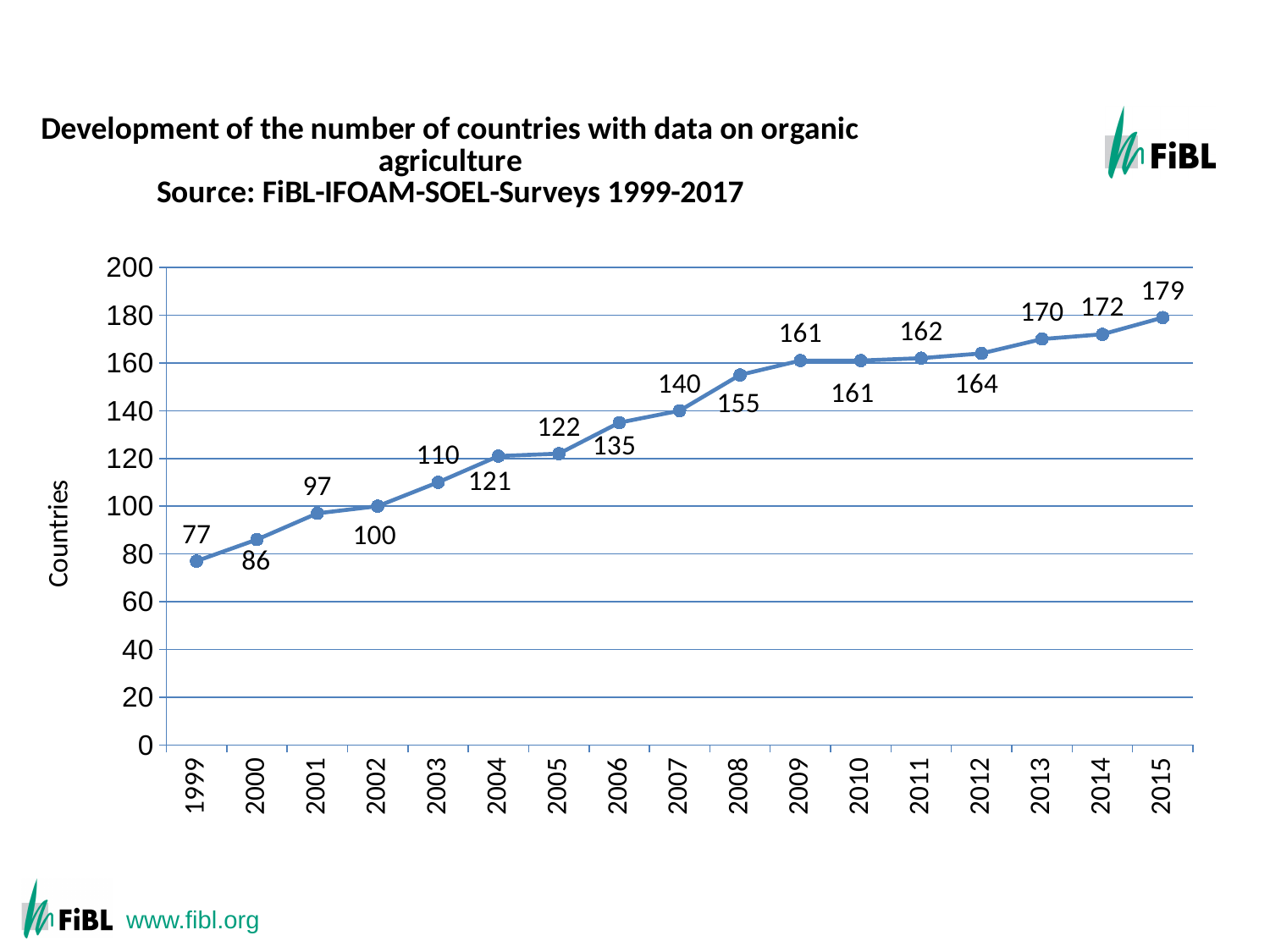
What is the difference between the number of countries in 2008 and in 2007? 15 Is the number of countries in 2002 greater or less than 120? less What kind of chart is shown on the slide? Line chart What is the difference between the number of countries in 2015 and in 1999? 102 Which year has the highest number of countries with data on organic agriculture? 2015 Do the values rise or fall from 1999 to 2015? Rise How many years are plotted on the chart? 17 What is the number of countries with data on organic agriculture in 2015? 179 What is the number of countries with data on organic agriculture in 2006? 135 What is the number of countries with data on organic agriculture in 1999? 77 Which year has the lowest number of countries with data on organic agriculture? 1999 Which year has more countries with data on organic agriculture, 2003 or 2012? 2012